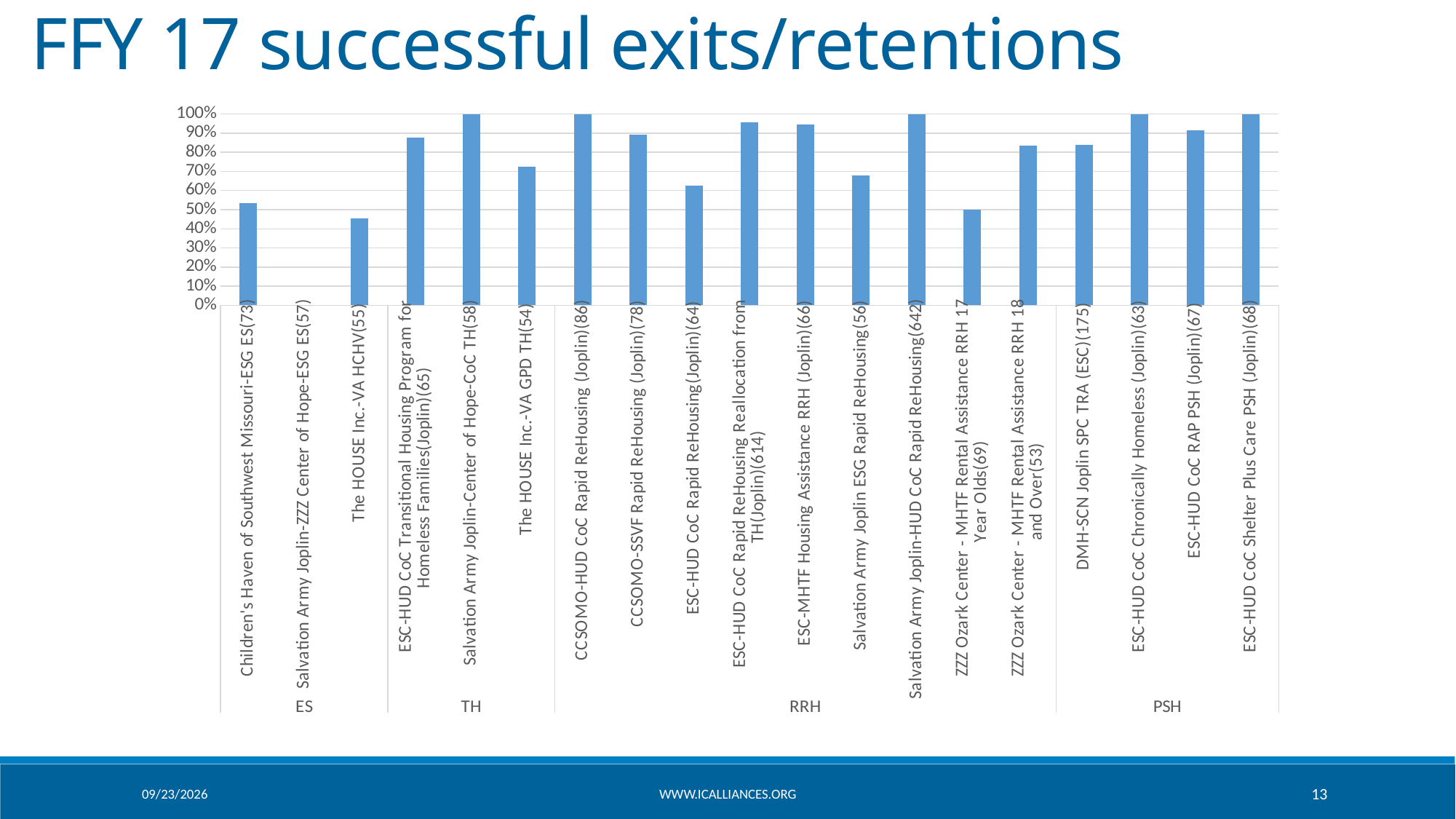
What kind of chart is shown on the slide? bar chart What are the four program-type group labels shown along the bottom of the x axis? ES, TH, RRH, PSH Is the value for The HOUSE Inc.-VA HCHV(55) greater or less than 50%? less What is the title of the chart on the slide? FFY 17 successful exits/retentions Is the value for Children's Haven of Southwest Missouri-ESG ES(73) greater or less than 50%? greater How many program categories (bars) are shown along the x axis? 19 What is the value for ESC-HUD CoC Shelter Plus Care PSH (Joplin)(68)? 100% Which program has the lowest value on the chart? Salvation Army Joplin-ZZZ Center of Hope-ESG ES(57) Which is larger, the value for ESC-HUD CoC Rapid ReHousing Reallocation from TH(Joplin)(614) or the value for ESC-HUD CoC Rapid ReHousing(Joplin)(64)? ESC-HUD CoC Rapid ReHousing Reallocation from TH(Joplin)(614) What is the value for Salvation Army Joplin-Center of Hope-CoC TH(58)? 100%